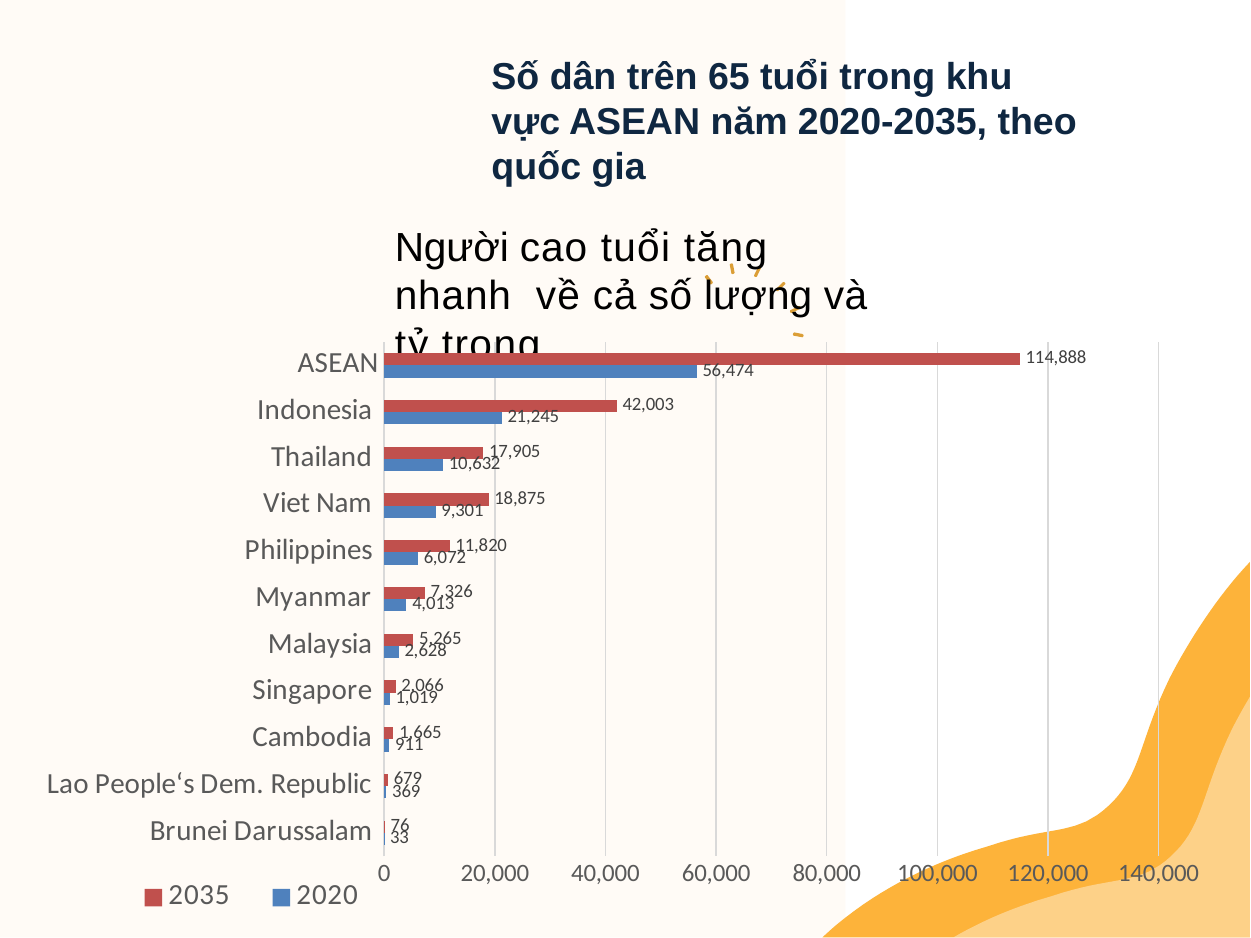
What is the difference between the 2035 and 2020 values for Thailand? 7,273 What is the 2035 value for Philippines? 11,820 Which is larger, the 2035 value for Viet Nam or the 2035 value for Thailand? Viet Nam How many series does the legend list? 2 What is the 2035 value for Indonesia? 42,003 What is the 2020 value for Viet Nam? 9,301 What kind of chart is shown on the slide? bar chart Excluding the ASEAN total, which country has the highest 2020 value? Indonesia Which category has the lowest 2035 value? Brunei Darussalam How many categories are shown on the chart? 11 What is the 2020 value for ASEAN? 56,474 Is the 2035 value for ASEAN greater or less than 100,000? greater